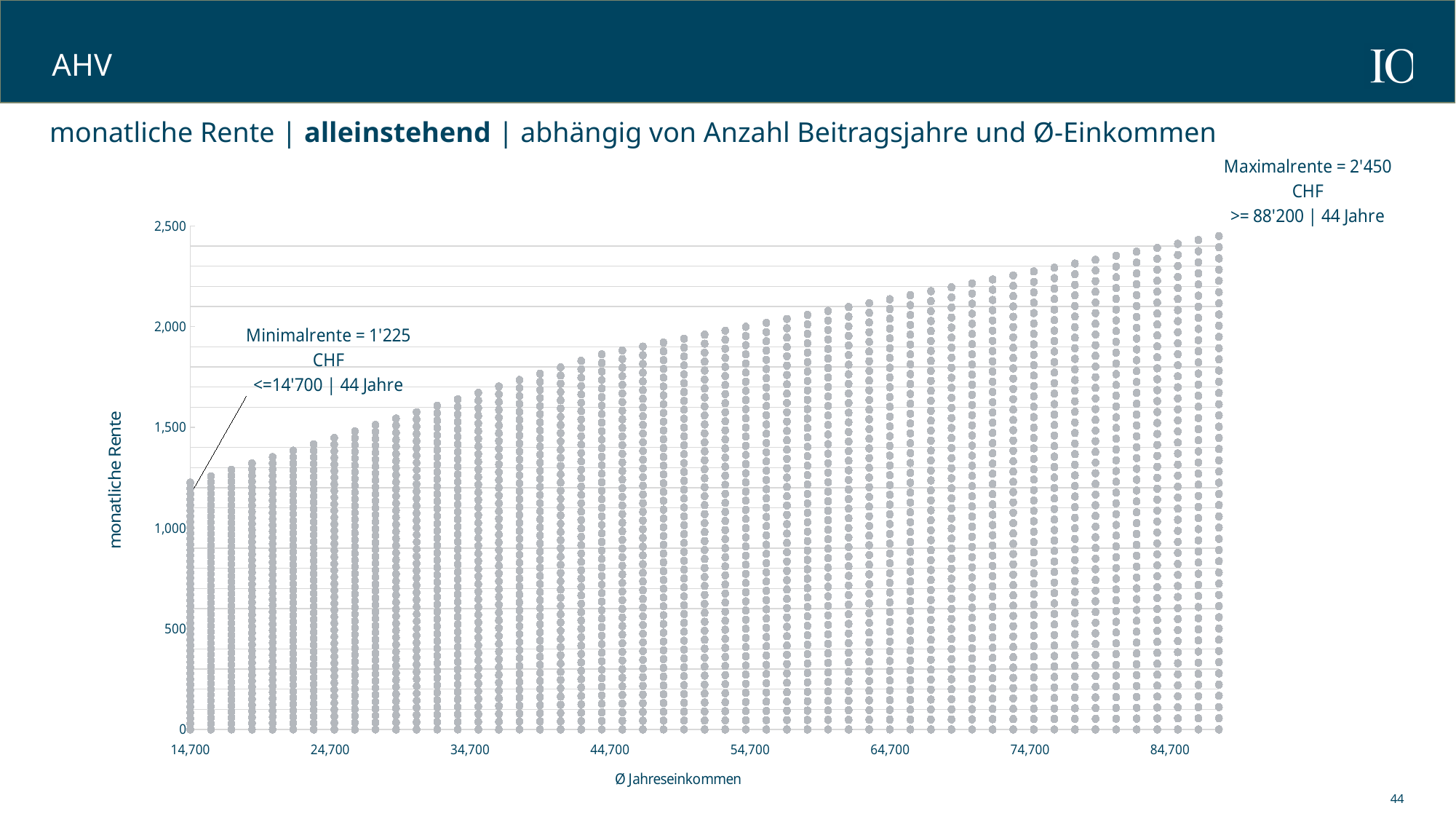
What kind of chart is shown on the slide? scatter chart Is the highest monthly pension at an income of 14,700 greater or less than 1,500? less Which income level shown on the x axis has the lowest top monthly pension? 14,700 According to the annotation, what is the Maximalrente? 2'450 CHF What is the title of the x axis? Ø Jahreseinkommen What is the difference between the Maximalrente and the Minimalrente shown in the annotations? 1'225 CHF Do the monthly pension values rise or fall as the average annual income increases along the x axis? rise At what average annual income and number of contribution years is the Maximalrente reached, according to the annotation? >= 88'200 | 44 Jahre What is the title of the y axis? monatliche Rente Is the highest monthly pension at an income of 84,700 greater or less than 2,000? greater Is the highest monthly pension at an income of 44,700 greater or less than 2,000? less According to the annotation, what is the Minimalrente? 1'225 CHF